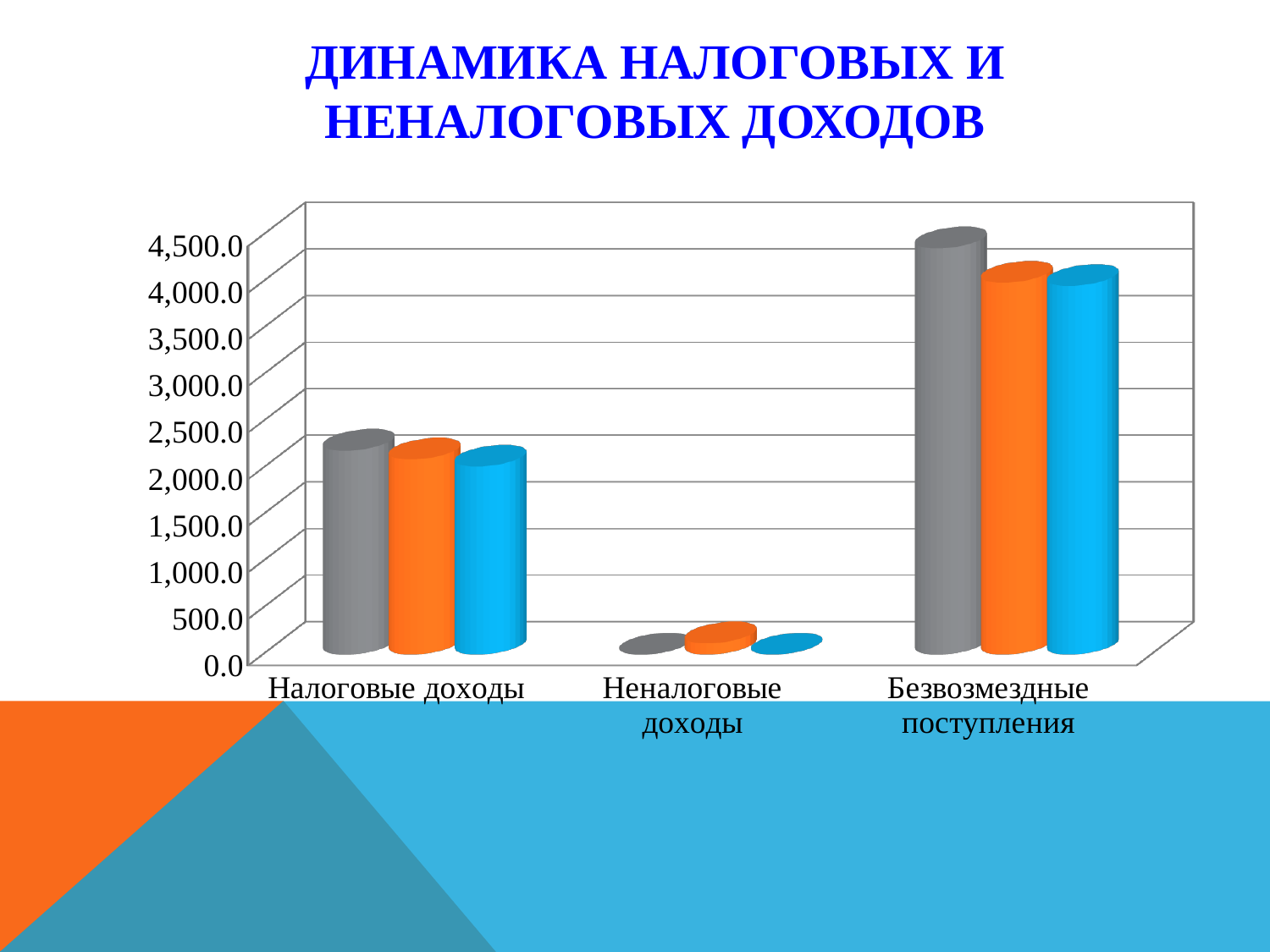
Which category has the highest bars in the chart? Безвозмездные поступления What kind of chart is shown on the slide? bar chart Which category has the lowest bars in the chart? Неналоговые доходы Which is larger, the gray bar for Налоговые доходы or the gray bar for Безвозмездные поступления? Безвозмездные поступления Are the values for Неналоговые доходы greater or less than 500.0? less How many bars are shown for each category in the chart? 3 Is the value of the gray bar for Налоговые доходы greater or less than 1,500.0? greater How many categories are shown on the x axis of the chart? 3 Is the value of the blue bar for Безвозмездные поступления greater or less than 3,500.0? greater What is the title of the slide? ДИНАМИКА НАЛОГОВЫХ И НЕНАЛОГОВЫХ ДОХОДОВ